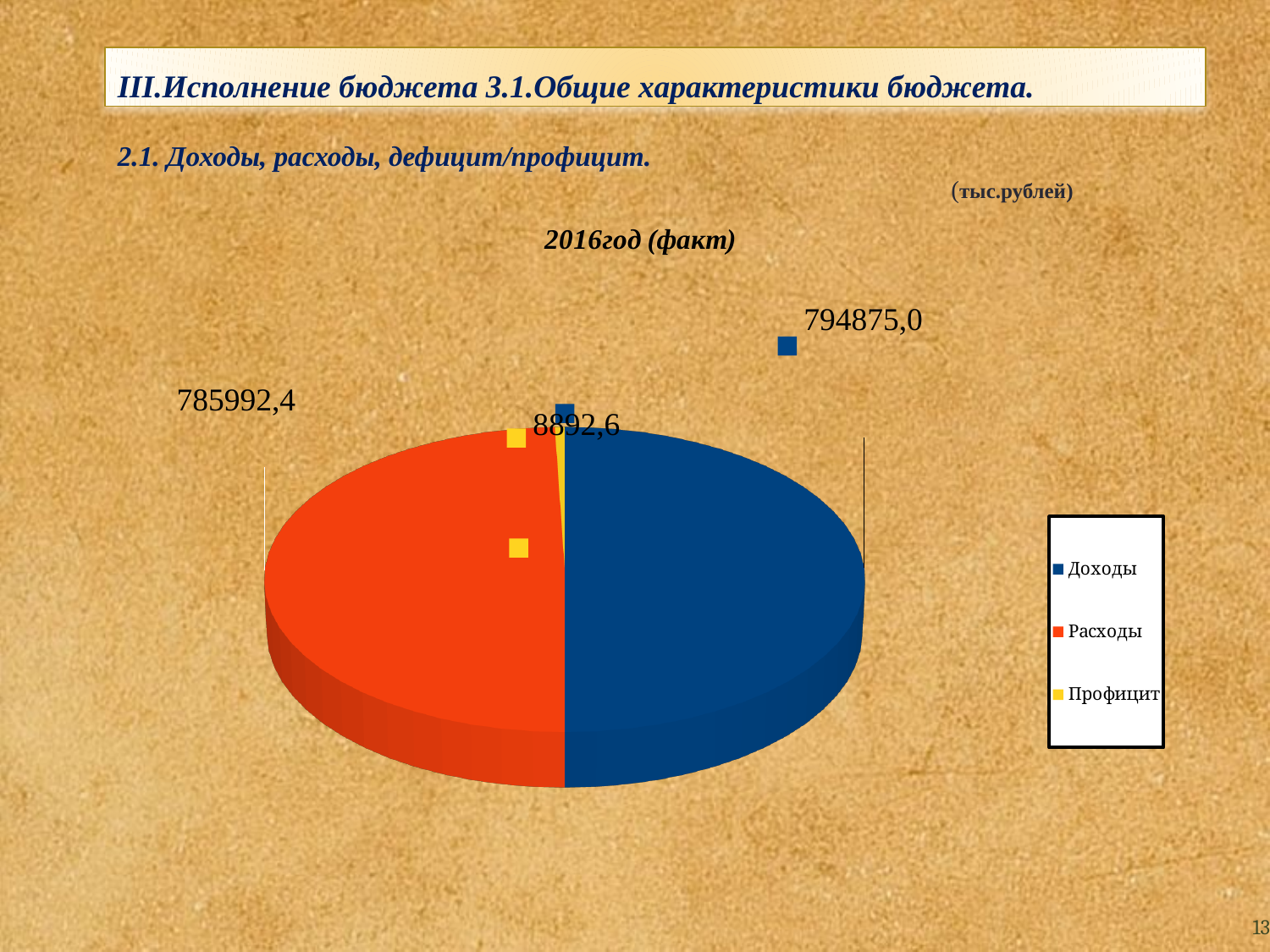
Which is larger, Доходы or Расходы? Доходы Which category has the smallest slice of the pie? Профицит How many slices does the pie chart have? 3 What is the value for Профицит? 8892,6 What colour is the Расходы slice? red What is the title of the chart? 2016год (факт) How many entries does the legend list? 3 Which category has the largest slice of the pie? Доходы What is the value for Расходы? 785992,4 What is the value for Доходы? 794875,0 What type of chart is shown on the slide? pie chart What is the difference between the values for Доходы and Расходы? 8882,6